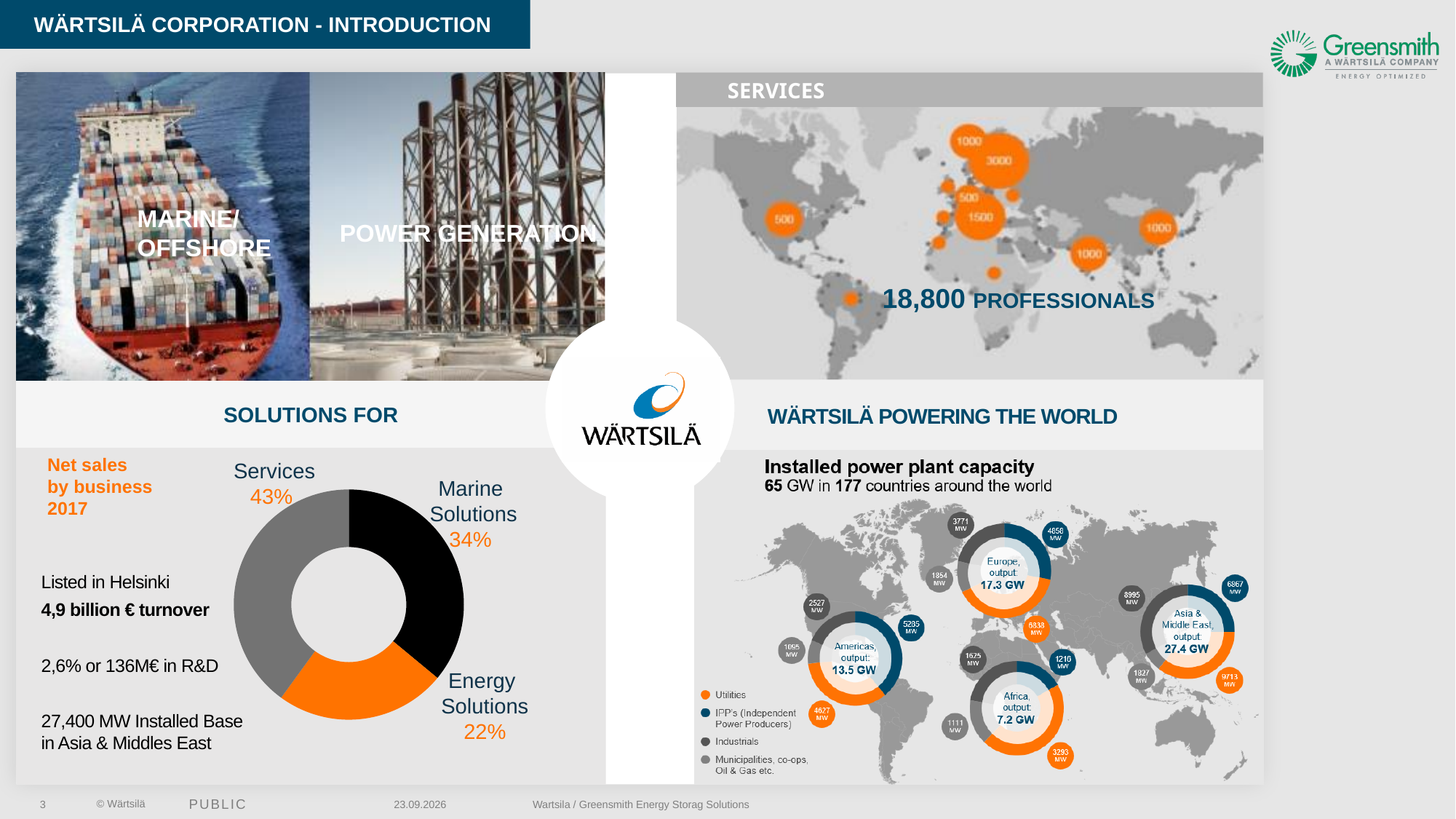
In the Net sales by business 2017 chart, what share of net sales comes from Marine Solutions? 34% In the Net sales by business 2017 chart, what share of net sales comes from Services? 43% In the Net sales by business 2017 chart, how many percentage points larger is the Services share than the Energy Solutions share? 21 In the Net sales by business 2017 chart, which is larger: the Marine Solutions share or the Energy Solutions share? Marine Solutions In the Net sales by business 2017 chart, which business has the smallest share of net sales? Energy Solutions In the Net sales by business 2017 chart, how many percentage points larger is the Services share than the Marine Solutions share? 9 In the Installed power plant capacity map, which region has the largest output? Asia & Middle East What kind of chart is used to show Net sales by business 2017? Donut (pie) chart In the Net sales by business 2017 chart, which business has the largest share of net sales? Services In the Net sales by business 2017 chart, what colour is the Energy Solutions slice? Orange How many business segments are shown in the Net sales by business 2017 chart? 3 In the Net sales by business 2017 chart, what share of net sales comes from Energy Solutions? 22%